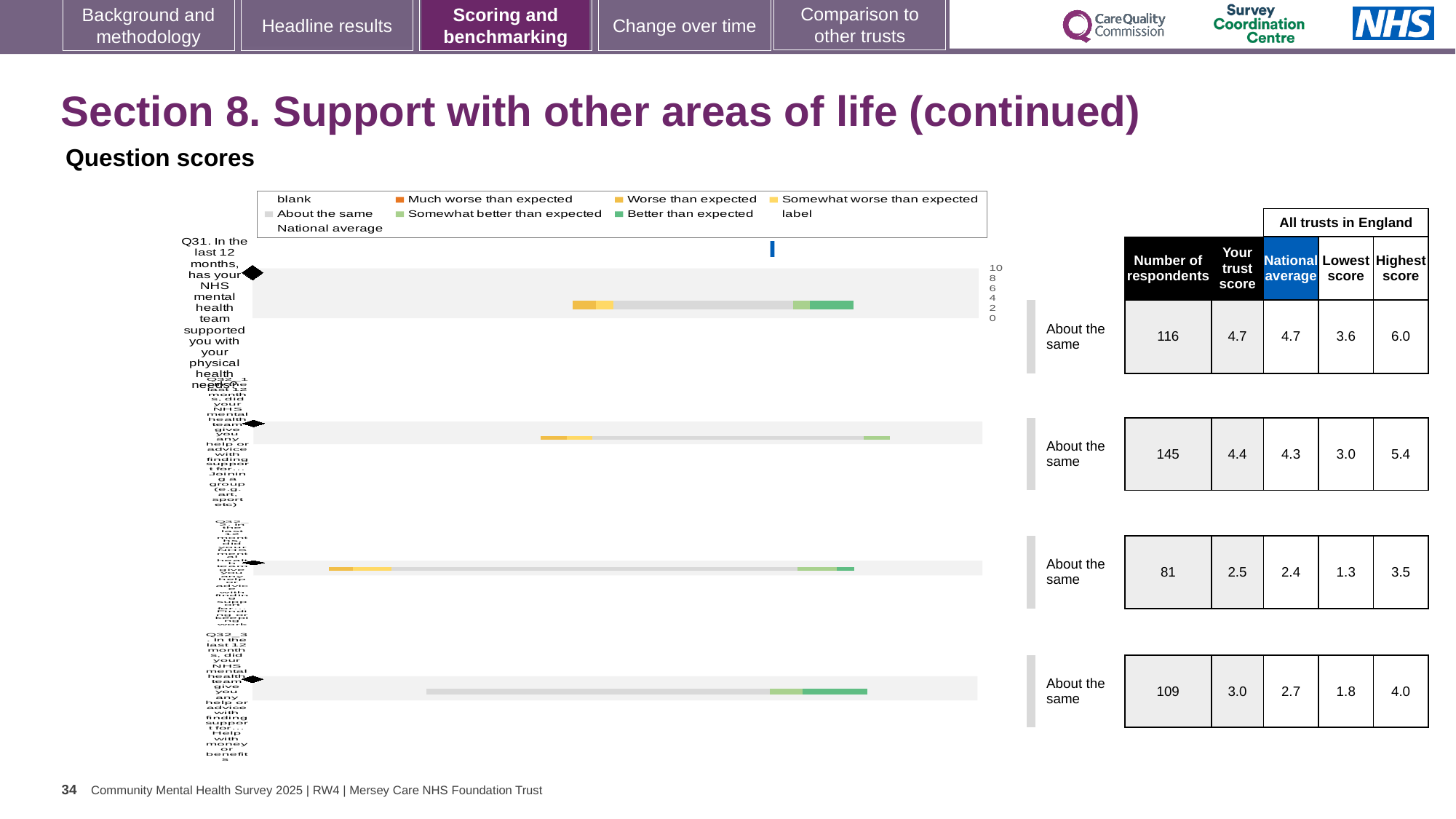
How many entries does the chart legend list? 9 What kind of chart is shown on the slide? bar chart What is the number of respondents for Q31 (support with physical health needs)? 116 Which legend entry is shown in grey in the chart? About the same What is the national average for Q32_1 (finding support for joining a group)? 4.3 For Q32_3, what is the difference between the trust score (3.0) and the national average (2.7)? 0.3 What is the heading above the chart? Question scores Which question row has the lowest number of respondents? Q32_2 How many question rows (categories) are plotted in the chart? 4 For Q32_1, which is larger: the trust score or the national average? the trust score What is the trust score for Q32_3 (help with money or benefits)? 3.0 Which question row has the highest number of respondents? Q32_1